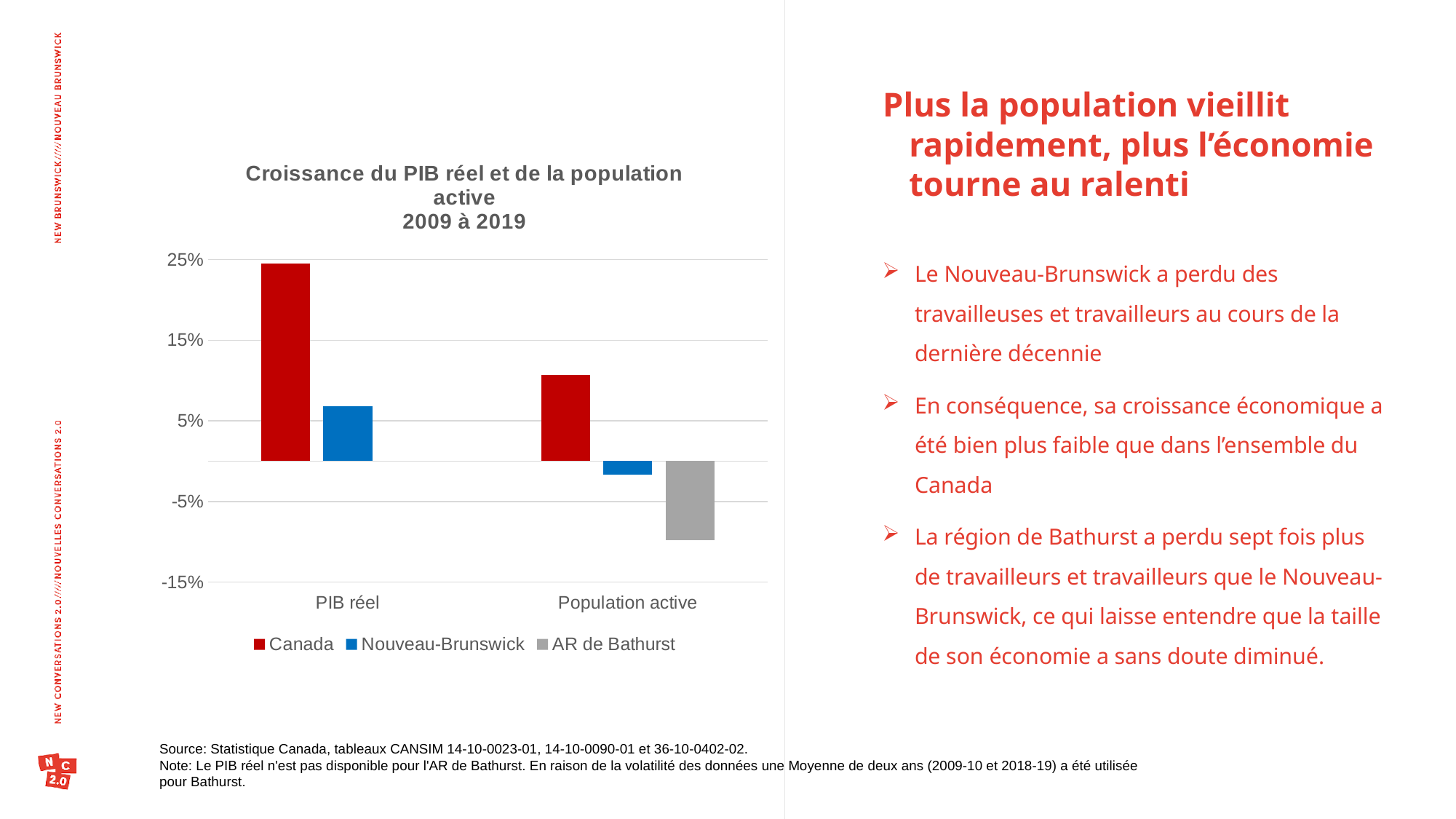
How many categories are shown on the x axis? 2 How many series does the legend list? 3 Is the value for Canada in PIB réel greater or less than 15%? greater Is the value for Nouveau-Brunswick in PIB réel greater or less than 5%? greater Is the value for AR de Bathurst in Population active greater or less than -5%? less What kind of chart is shown on the slide? bar chart Which series has no bar in the PIB réel category? AR de Bathurst Which series has the highest value for PIB réel? Canada Which series is shown in grey in the legend? AR de Bathurst Which is larger: Canada's value for PIB réel or Canada's value for Population active? PIB réel Which series has the lowest value for Population active? AR de Bathurst